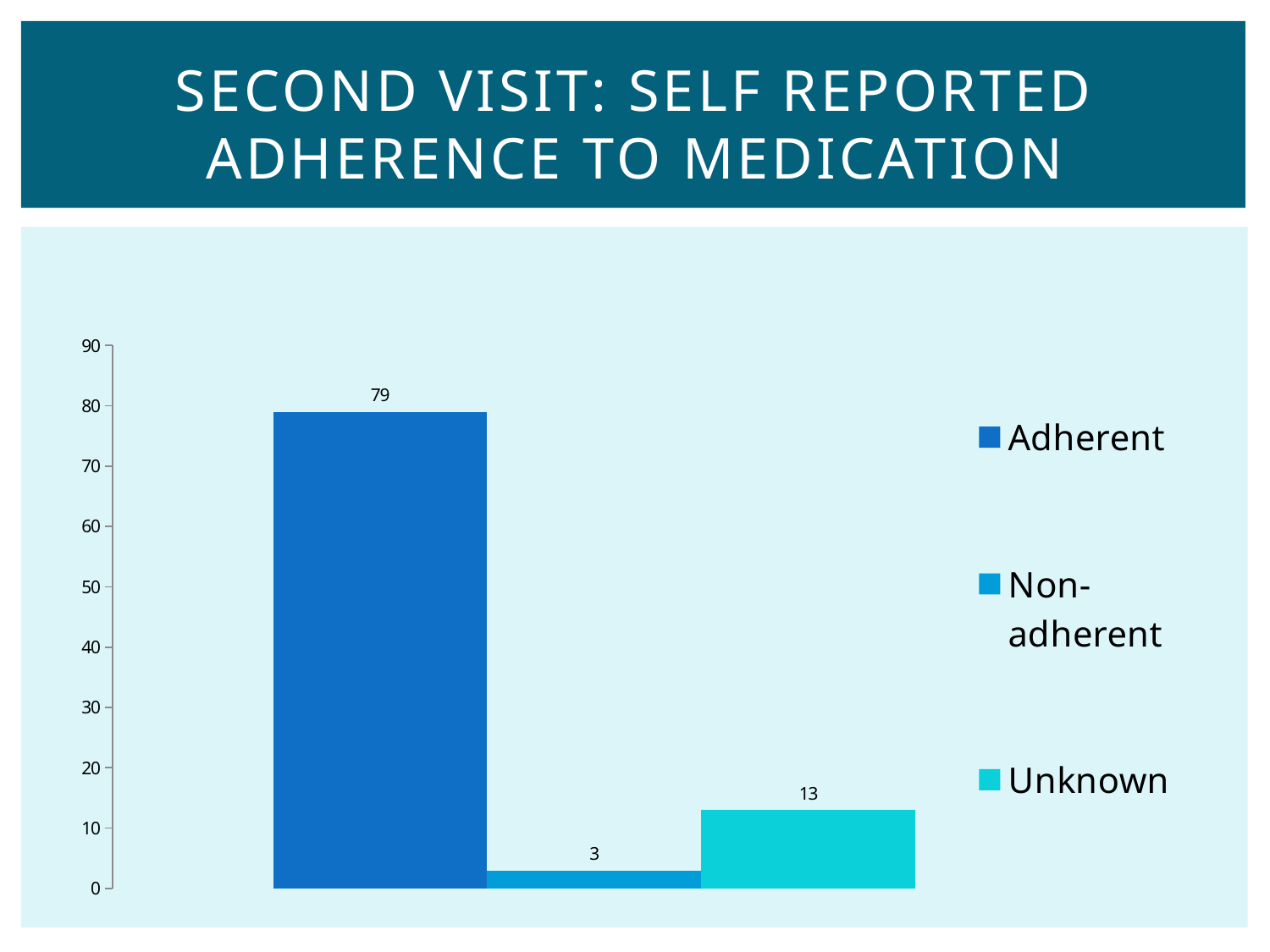
Is the value for Adherent greater or less than 70? greater Which category has the highest value? Adherent What is the difference between the Adherent and Unknown values? 66 What is the value for Non-adherent? 3 What is the difference between the Unknown and Non-adherent values? 10 What kind of chart is shown on the slide? bar chart Which category has the lowest value? Non-adherent What is the title of the slide? Second Visit: Self Reported Adherence to Medication What is the value for Unknown? 13 What is the value for Adherent? 79 How many series does the legend list? 3 Which is larger, the value for Unknown or the value for Non-adherent? Unknown